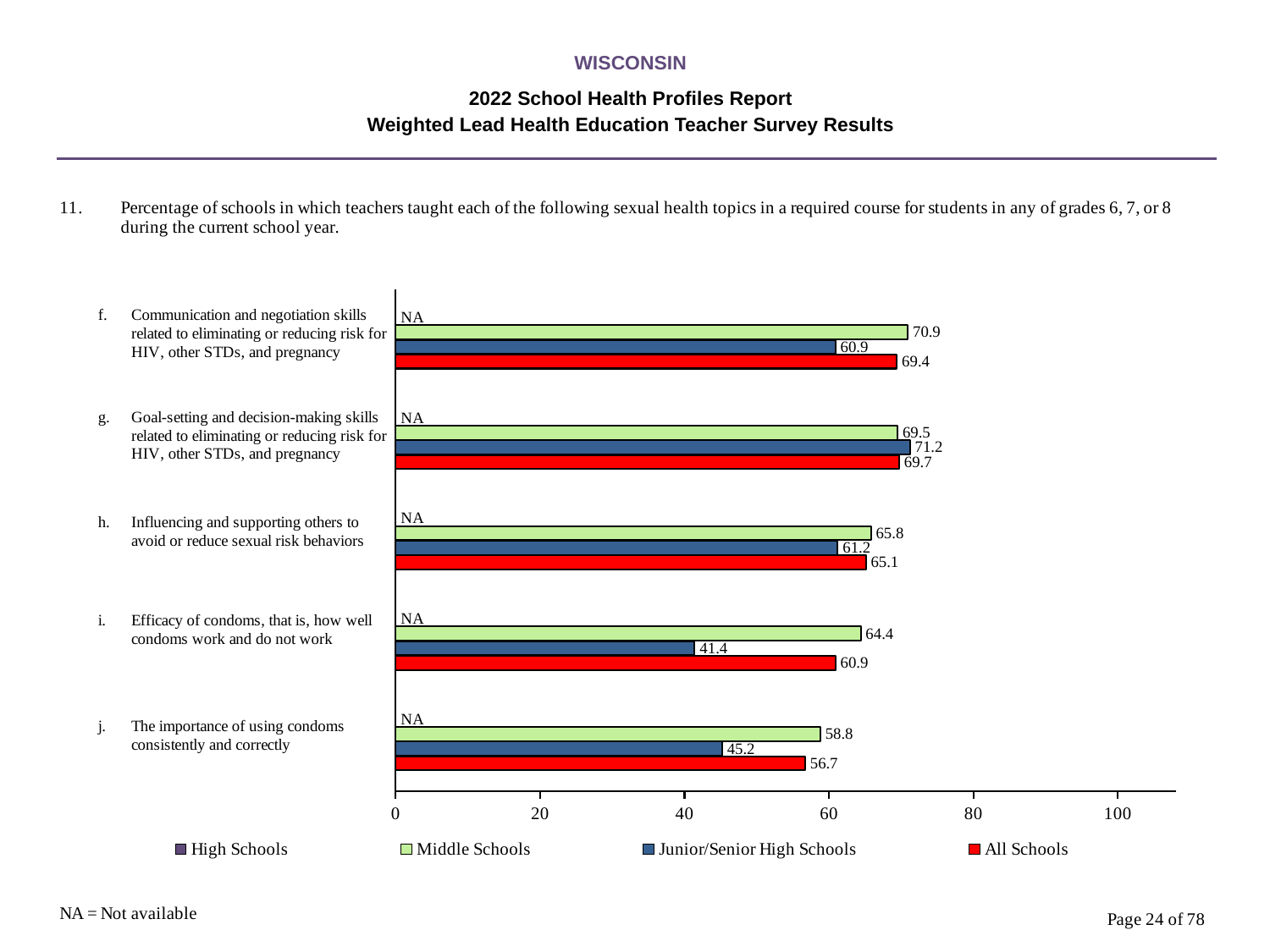
Which topic has the highest Middle Schools value? f. Communication and negotiation skills related to eliminating or reducing risk for HIV, other STDs, and pregnancy Which topic has the lowest Junior/Senior High Schools value? i. Efficacy of condoms, that is, how well condoms work and do not work How many sexual health topics are plotted on the chart? 5 What is the Junior/Senior High Schools value for topic j, the importance of using condoms consistently and correctly? 45.2 What kind of chart is shown on the slide? Bar chart What is the difference between the All Schools values for topic f and topic j? 12.7 What is the All Schools value for topic f, communication and negotiation skills related to eliminating or reducing risk for HIV, other STDs, and pregnancy? 69.4 For topic g, goal-setting and decision-making skills, which is larger: the Middle Schools value or the Junior/Senior High Schools value? Junior/Senior High Schools For topic i, efficacy of condoms, how much higher is the Middle Schools value than the Junior/Senior High Schools value? 23.0 What is shown for the High Schools series for each topic? NA What is the Middle Schools value for topic i, efficacy of condoms, that is, how well condoms work and do not work? 64.4 How many series does the legend list? 4